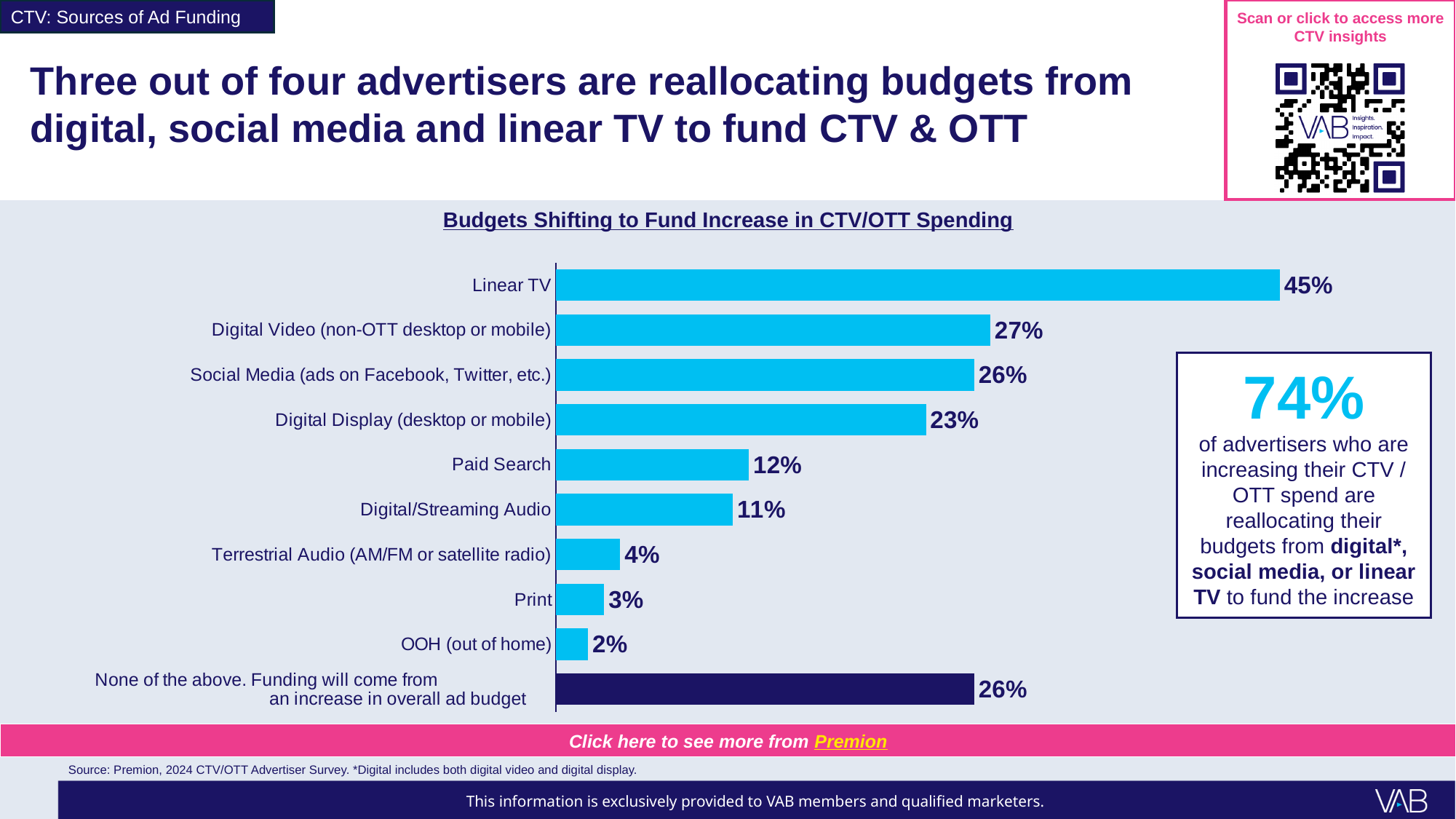
What is the value for Print? 3% What is the difference between the values for Linear TV and Digital Video (non-OTT desktop or mobile)? 18% What is the title of the chart? Budgets Shifting to Fund Increase in CTV/OTT Spending What is the value for Linear TV? 45% Which category has the highest value? Linear TV What is the difference between the values for Digital Display (desktop or mobile) and Digital/Streaming Audio? 12% What kind of chart is shown on the slide? Bar chart How many categories are shown in the chart? 10 What is the value for Paid Search? 12% Which is larger, the value for Terrestrial Audio (AM/FM or satellite radio) or the value for Print? Terrestrial Audio (AM/FM or satellite radio) Which category has the lowest value? OOH (out of home) What is the value for 'None of the above. Funding will come from an increase in overall ad budget'? 26%